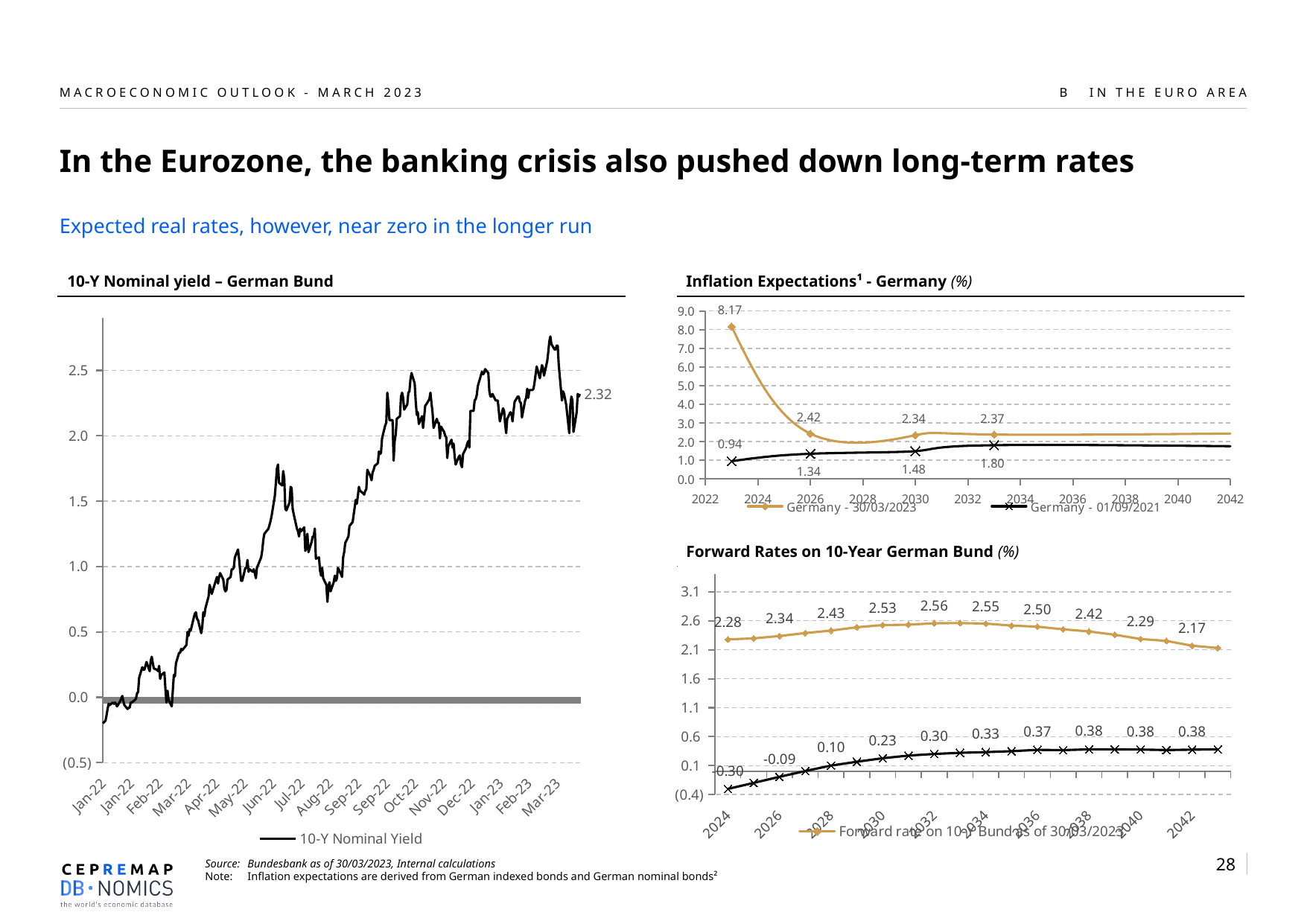
On the '10-Y Nominal yield – German Bund' chart, does the yield overall rise or fall from Jan-22 to Mar-23? rise On the 'Forward Rates on 10-Year German Bund' chart, what is the highest labeled value of the gold 'Forward rate on 10-y Bund as of 30/03/2023' series? 2.56 On the '10-Y Nominal yield – German Bund' chart, is the yield at the start of Jan-22 greater or less than 0.5? less On the 'Inflation Expectations - Germany' chart, what is the last labeled value of the 'Germany - 01/09/2021' series? 1.80 On the 'Forward Rates on 10-Year German Bund' chart, what is the lowest labeled value of the black series? -0.30 On the 'Inflation Expectations - Germany' chart, what is the first labeled value of the 'Germany - 30/03/2023' series? 8.17 On the '10-Y Nominal yield – German Bund' chart, what is the latest value labeled at the end of the line? 2.32 How many series does the legend of the 'Inflation Expectations - Germany' chart list? 2 On the 'Forward Rates on 10-Year German Bund' chart, which series has higher values throughout: the gold series or the black series? the gold series On the 'Forward Rates on 10-Year German Bund' chart, what is the last labeled value of the gold series? 2.17 What kind of chart is the '10-Y Nominal yield – German Bund' chart? line chart On the 'Inflation Expectations - Germany' chart, what is the difference between the first labeled values of the two series (8.17 and 0.94)? 7.23